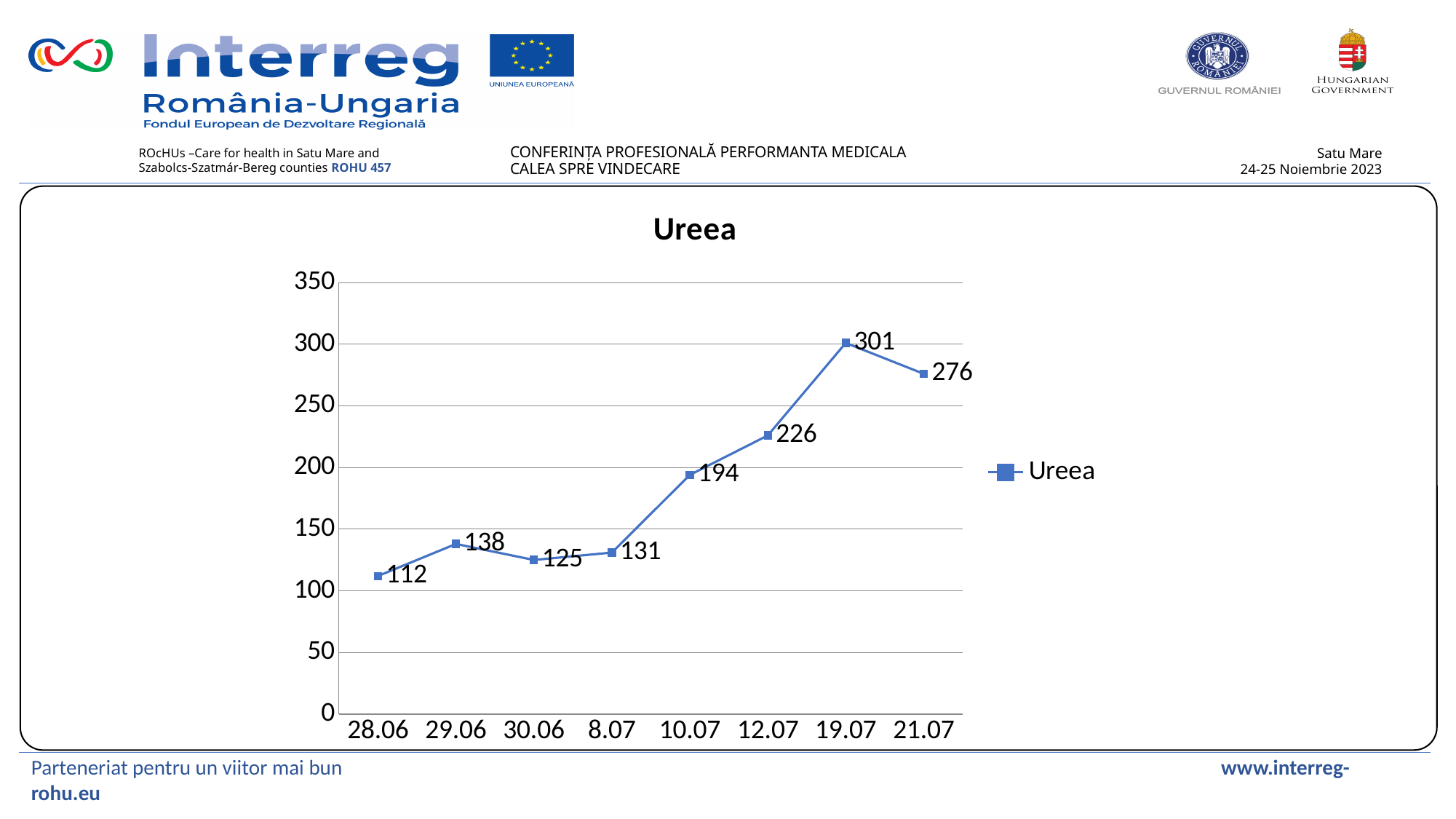
How many dates are plotted on the chart? 8 Which date has a larger Ureea value, 29.06 or 30.06? 29.06 What is the Ureea value on 21.07? 276 Is the Ureea value on 12.07 greater or less than 200? greater On which date is the Ureea value highest? 19.07 What is the Ureea value on 10.07? 194 What is the title of the chart? Ureea What is the Ureea value on 28.06? 112 What is the difference between the Ureea values on 12.07 and 10.07? 32 What is the difference between the Ureea values on 19.07 and 21.07? 25 On which date is the Ureea value lowest? 28.06 What kind of chart is shown on the slide? line chart